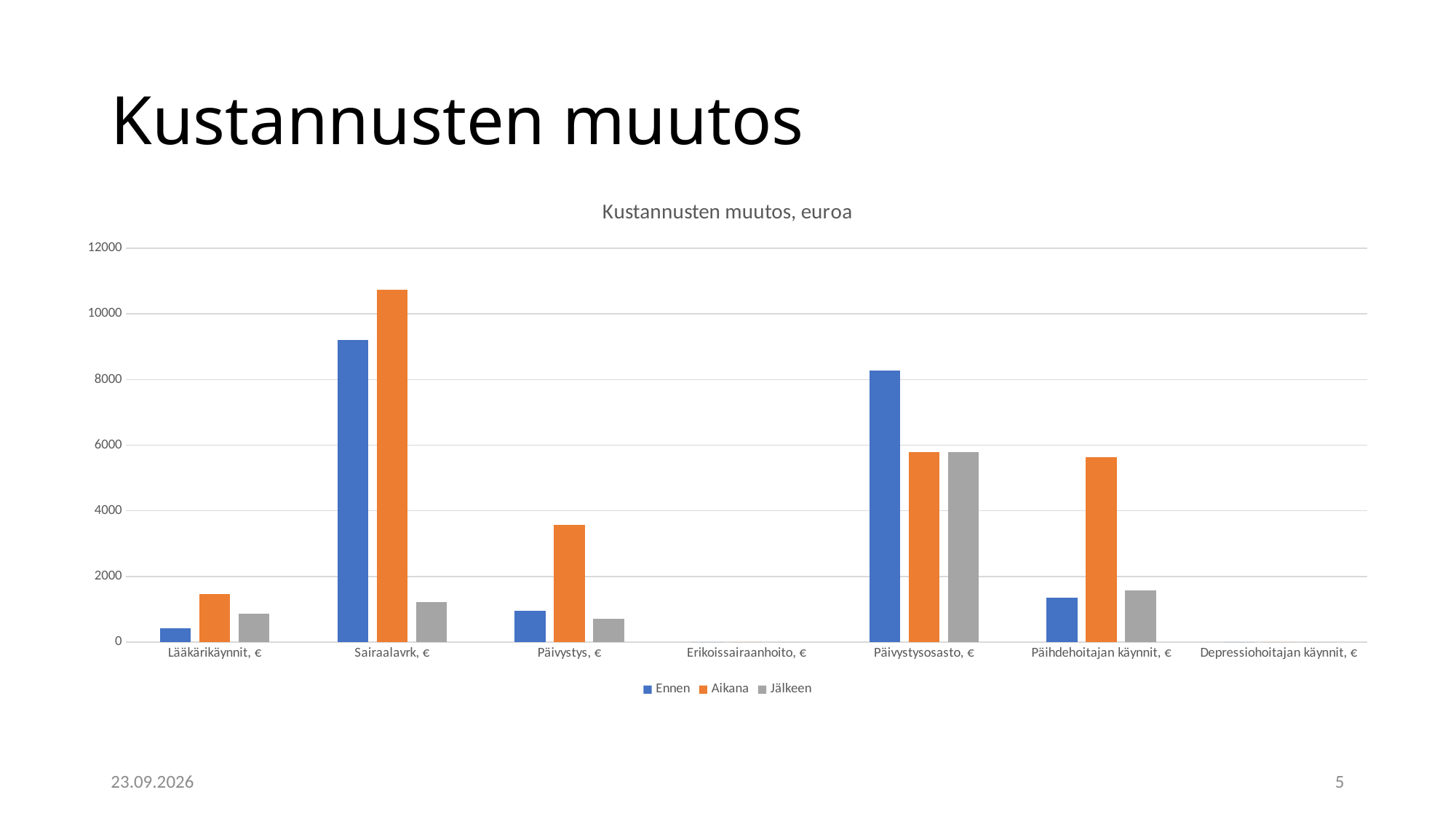
For Sairaalavrk, €, which is larger: the Ennen value or the Aikana value? Aikana Is the Ennen value for Sairaalavrk, € greater or less than 8000? greater How many series does the legend list? 3 Which category has the highest Aikana value? Sairaalavrk, € Is the Aikana value for Sairaalavrk, € greater or less than 10000? greater Is the Jälkeen value for Sairaalavrk, € greater or less than 2000? less What is the title of the chart? Kustannusten muutos, euroa How many categories are shown on the x axis? 7 For Päivystysosasto, €, which is larger: the Ennen value or the Aikana value? Ennen Which series has the highest value for Päihdehoitajan käynnit, €? Aikana What kind of chart is shown on the slide? bar chart